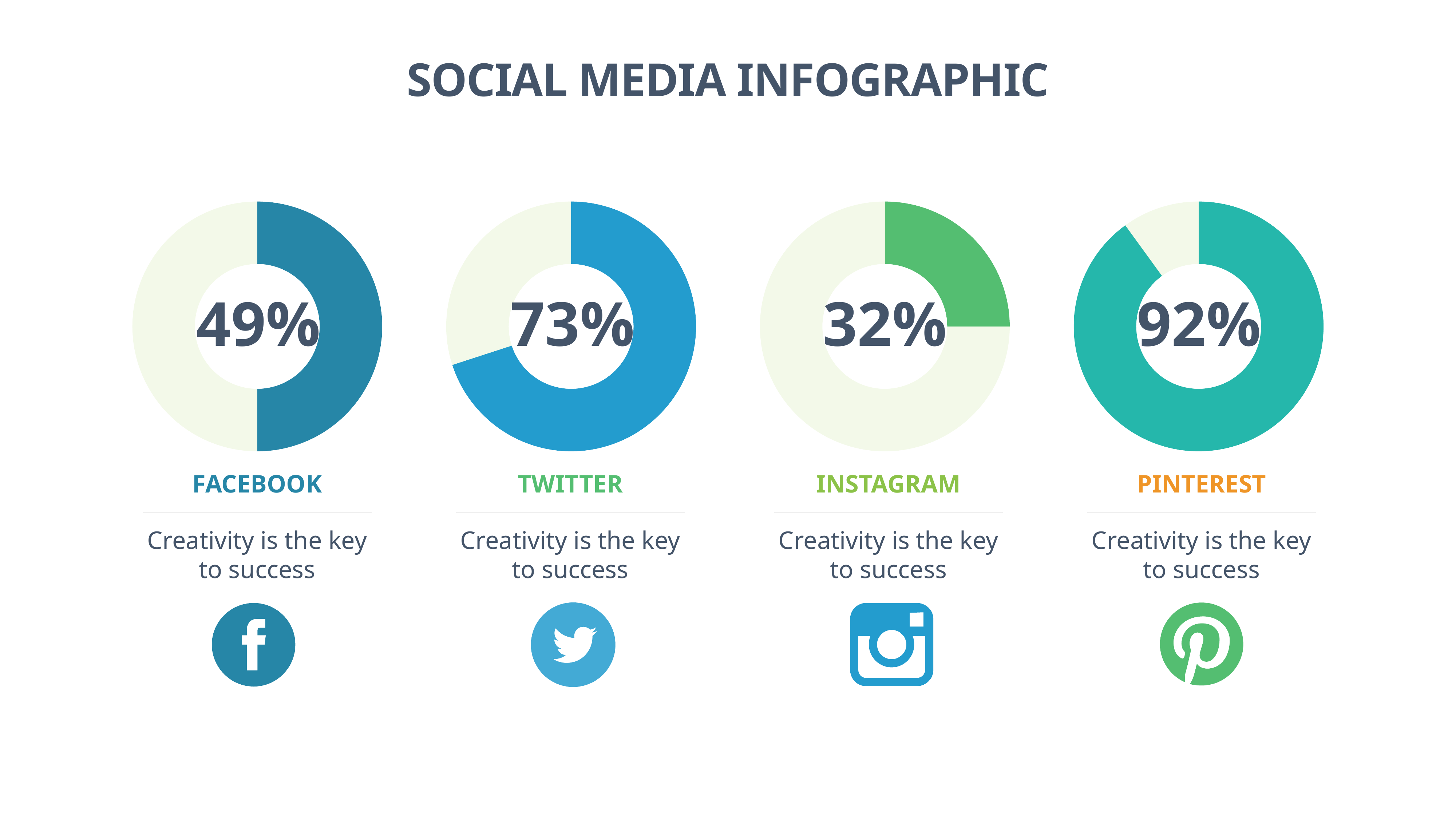
Which platform has the highest percentage shown on the slide? Pinterest Which platform has the lowest percentage shown on the slide? Instagram Which has a larger percentage, Facebook or Twitter? Twitter What kind of chart is used for each platform on the slide? Donut chart What percentage is shown in the Pinterest donut chart? 92% What percentage is shown in the Facebook donut chart? 49% How many donut charts are shown on the slide? 4 What is the difference between the Twitter percentage and the Instagram percentage? 41% What percentage is shown in the Instagram donut chart? 32% What percentage is shown in the Twitter donut chart? 73% What is the title of the slide? SOCIAL MEDIA INFOGRAPHIC What is the difference between the Pinterest percentage and the Facebook percentage? 43%